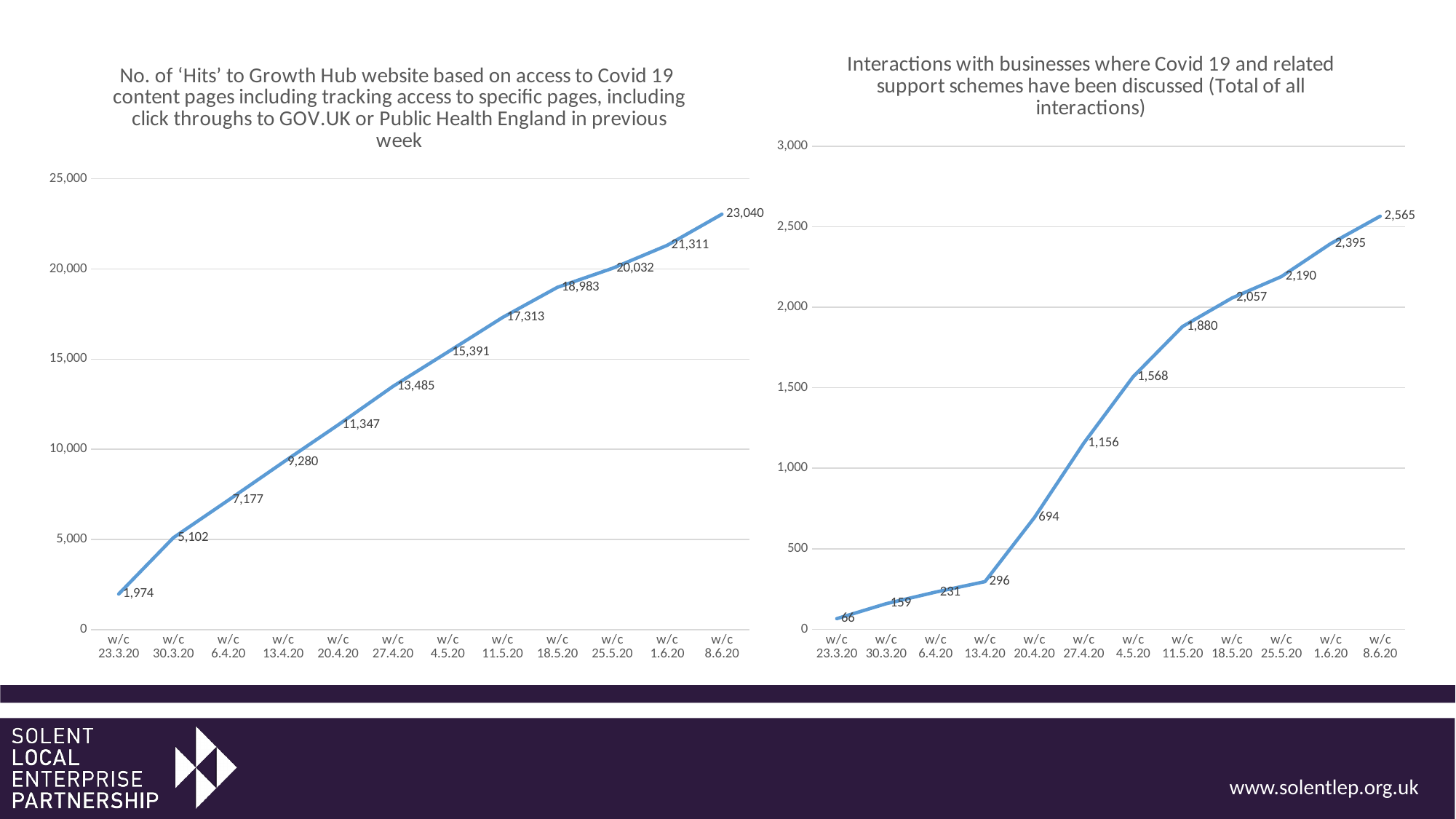
In the right chart (Interactions with businesses), is the value for w/c 27.4.20 greater or less than 1,000? greater In the left chart (No. of 'Hits' to Growth Hub website), what is the difference between the values for w/c 8.6.20 and w/c 1.6.20? 1,729 In the right chart (Interactions with businesses), what is the value for w/c 23.3.20? 66 What type of chart is the right chart (Interactions with businesses)? Line chart In the left chart (No. of 'Hits' to Growth Hub website), what is the value for w/c 13.4.20? 9,280 In the left chart (No. of 'Hits' to Growth Hub website), what is the value for w/c 8.6.20? 23,040 In the right chart (Interactions with businesses), which week has the highest value? w/c 8.6.20 In the right chart (Interactions with businesses), what is the difference between the values for w/c 11.5.20 and w/c 4.5.20? 312 In the left chart (No. of 'Hits' to Growth Hub website), which week has the lowest value? w/c 23.3.20 In the left chart (No. of 'Hits' to Growth Hub website), do the values rise or fall from w/c 23.3.20 to w/c 8.6.20? Rise How many data points are plotted in the left chart (No. of 'Hits' to Growth Hub website)? 12 In the right chart (Interactions with businesses), what is the value for w/c 20.4.20? 694